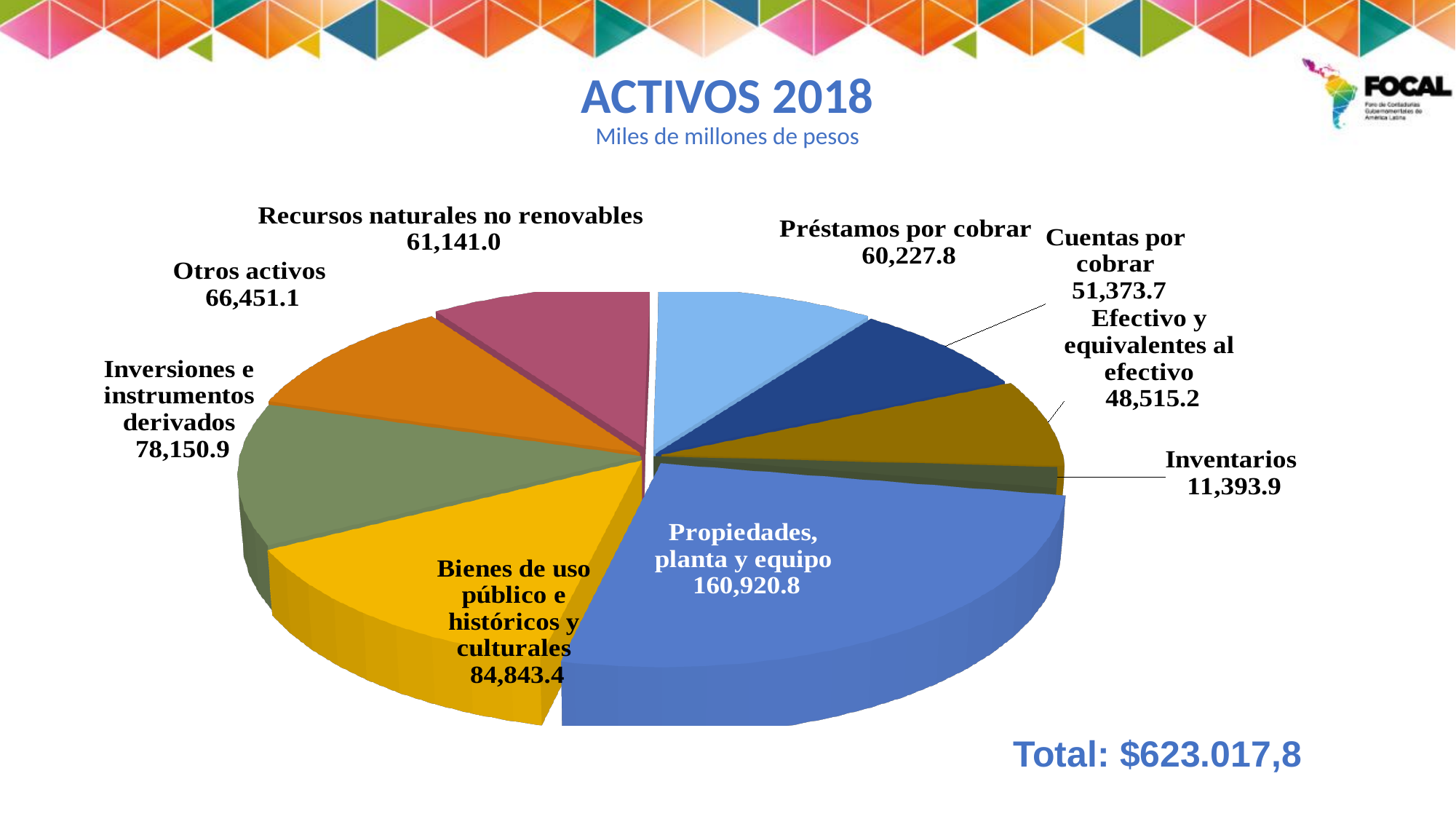
What is the difference between Propiedades, planta y equipo and Bienes de uso público e históricos y culturales? 76,077.4 What is the difference between Préstamos por cobrar and Cuentas por cobrar? 8,854.1 What unit is stated under the chart title? Miles de millones de pesos Which category has the largest slice of the pie? Propiedades, planta y equipo What is the value for Propiedades, planta y equipo? 160,920.8 What kind of chart is shown on the slide? Pie chart What is the value for Inventarios? 11,393.9 What total is printed on the slide for the assets? $623.017,8 What is the value for Efectivo y equivalentes al efectivo? 48,515.2 How many categories (slices) does the pie chart have? 9 Which category has the smallest slice of the pie? Inventarios Which is larger, Otros activos or Recursos naturales no renovables? Otros activos